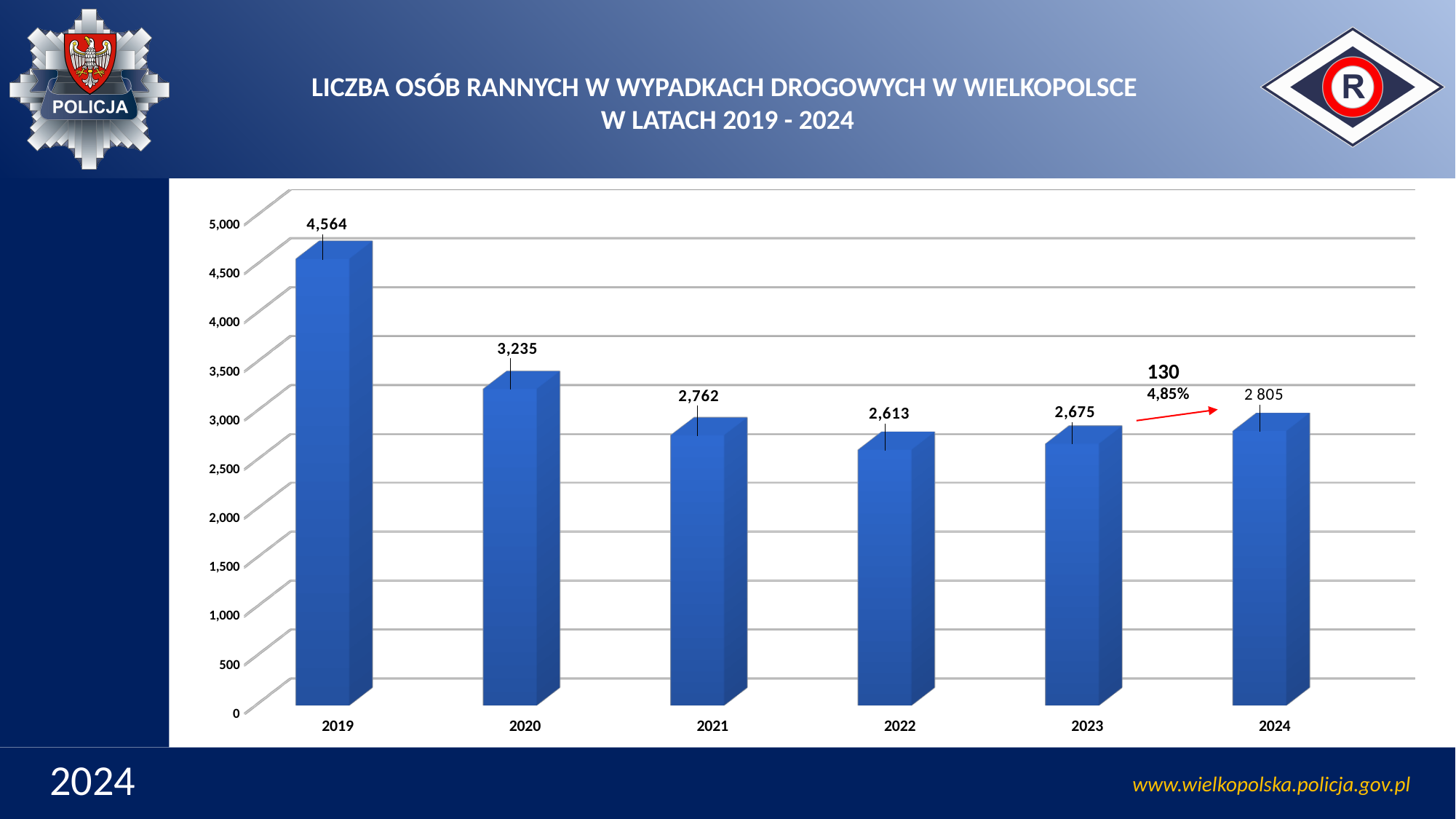
What is the value shown for 2022? 2,613 What kind of chart is shown on the slide? bar chart What percentage change is annotated between 2023 and 2024? 4,85% What is the difference between the values for 2019 and 2020? 1,329 Which year has the highest value? 2019 Is the value for 2020 greater or less than 3,000? greater What is the value shown for 2024? 2 805 Which year has the lowest value? 2022 By how much did the value change from 2023 to 2024, as annotated on the chart? 130 Which is larger, the value for 2021 or the value for 2023? 2021 How many years are shown on the x axis? 6 What is the number of injured persons shown for 2019? 4,564